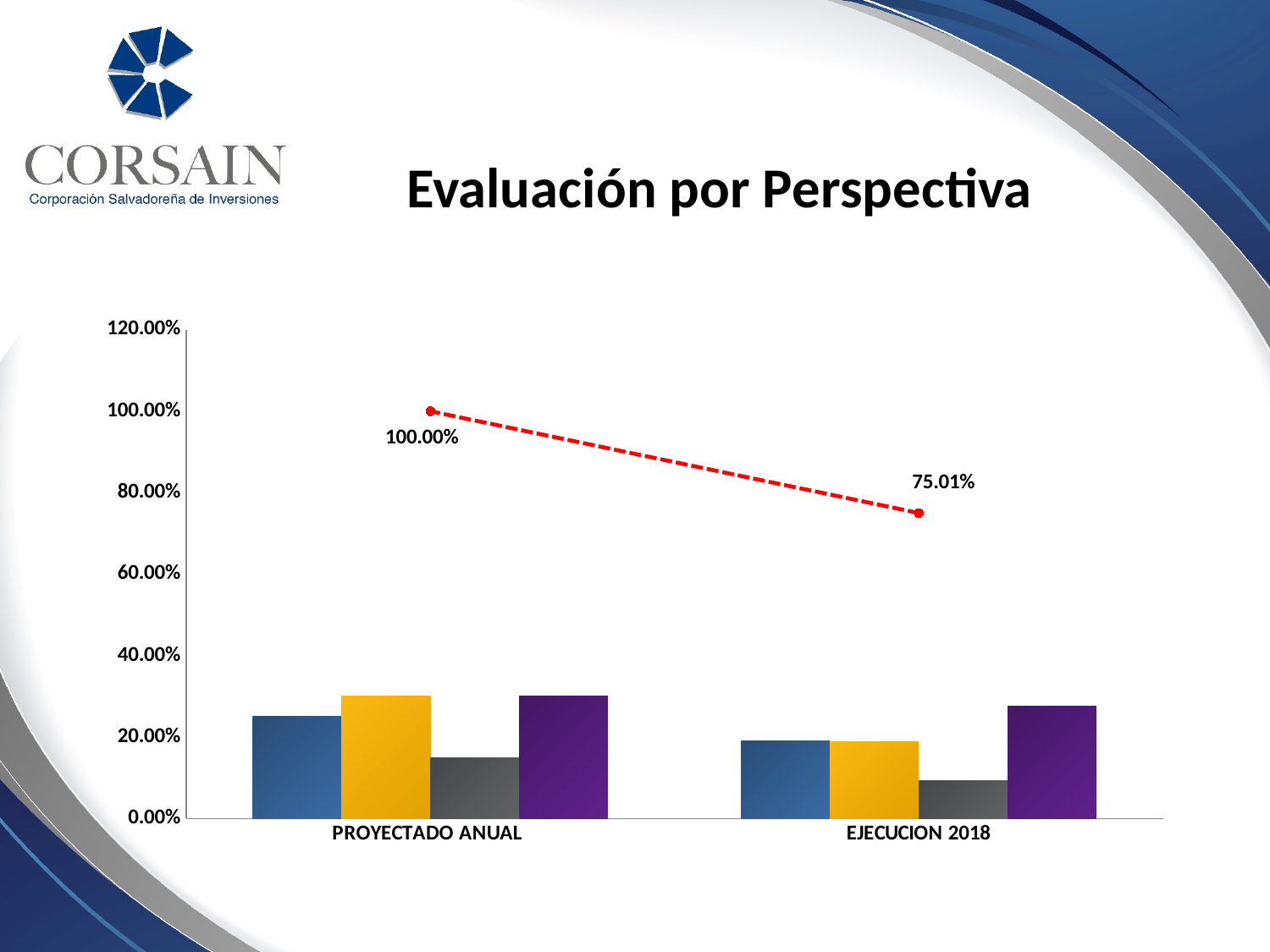
What kind of chart is shown on the slide? A combined bar and line chart What is the difference between the red line's values for PROYECTADO ANUAL and EJECUCION 2018? 24.99% What value does the red dashed line show for PROYECTADO ANUAL? 100.00% Is the value of the purple bar for EJECUCION 2018 greater or less than 20.00%? greater Is the value of the yellow bar for PROYECTADO ANUAL greater or less than 20.00%? greater What value does the red dashed line show for EJECUCION 2018? 75.01% Which coloured bar is the tallest in the EJECUCION 2018 group? The purple bar How many categories are shown on the x axis? 2 Does the red dashed line rise or fall from PROYECTADO ANUAL to EJECUCION 2018? Falls Is the value of the grey bar for EJECUCION 2018 greater or less than 20.00%? less What is the title of the chart on the slide? Evaluación por Perspectiva Which category has the higher value on the red dashed line, PROYECTADO ANUAL or EJECUCION 2018? PROYECTADO ANUAL